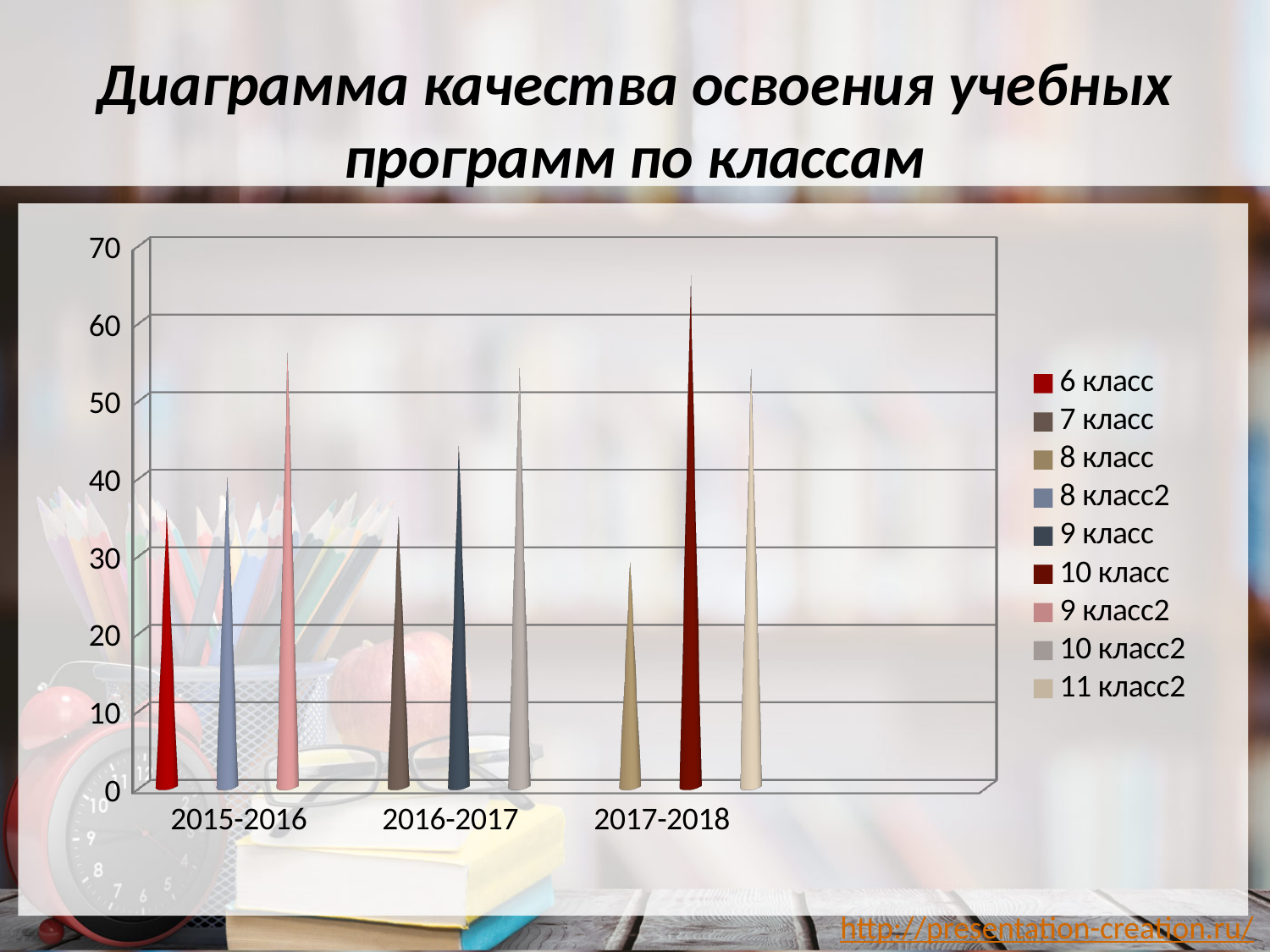
How many series does the legend list? 9 Which is larger: the value for 9 класс in 2016-2017 or the value for 10 класс2 in 2016-2017? 10 класс2 Is the value for 6 класс in 2015-2016 greater or less than 40? less Is the value for 10 класс in 2017-2018 greater or less than 60? greater What is the title of the slide containing the chart? Диаграмма качества освоения учебных программ по классам Which series has the tallest bar on the chart? 10 класс How many school-year categories are shown on the x axis? 3 Which is larger: the value for 6 класс in 2015-2016 or the value for 9 класс2 in 2015-2016? 9 класс2 Which series has the shortest bar on the chart? 8 класс Is the value for 9 класс2 in 2015-2016 greater or less than 50? greater What kind of chart is shown on the slide? bar chart